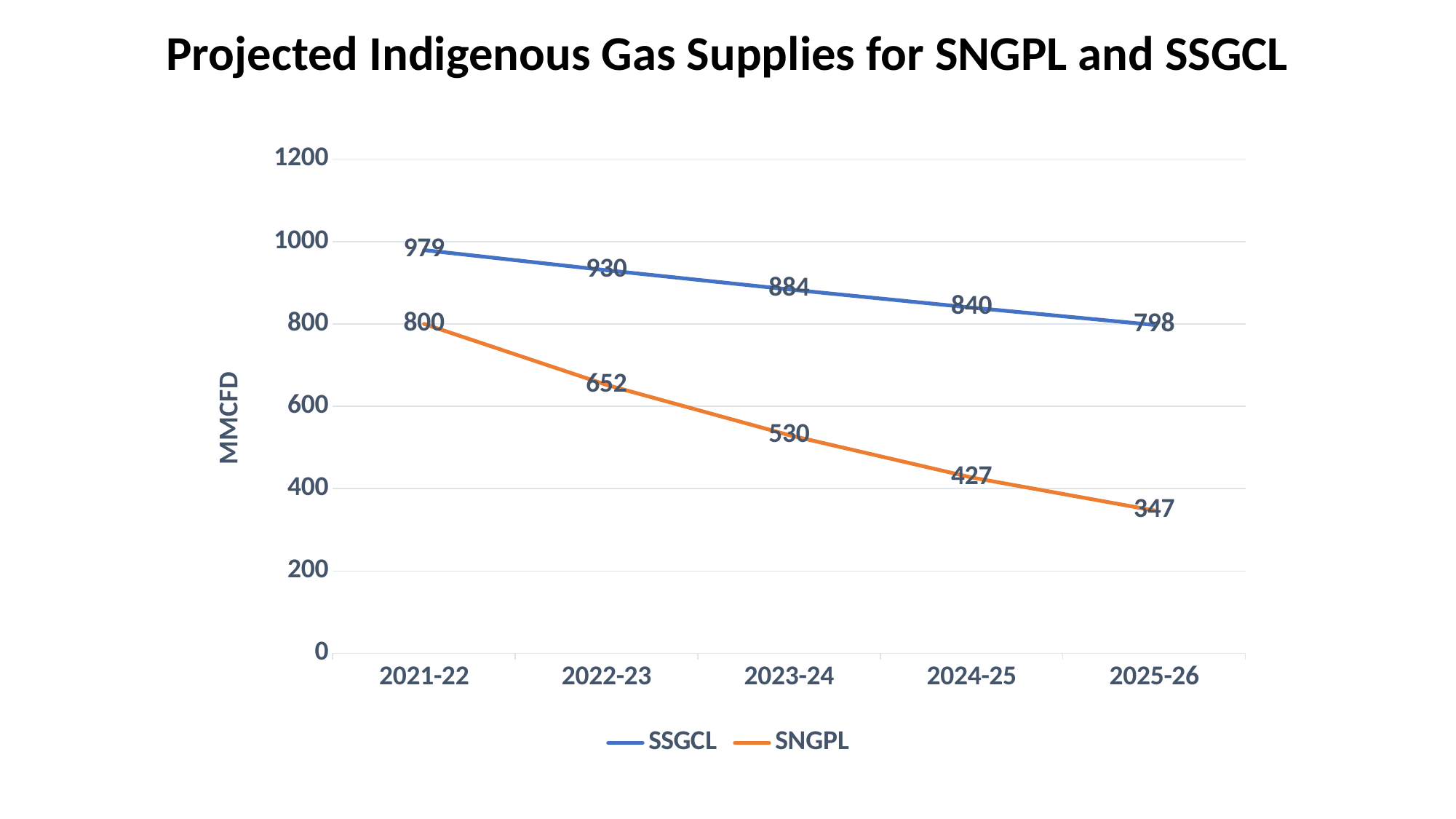
What is the projected SNGPL gas supply for 2025-26? 347 Which is larger in 2022-23, the SSGCL supply or the SNGPL supply? SSGCL In which year is the SSGCL supply highest? 2021-22 What kind of chart is shown on the slide? Line chart What is the difference between the SSGCL and SNGPL supplies in 2024-25? 413 Do the SSGCL values rise or fall from 2021-22 to 2025-26? Fall How many series does the legend list? 2 What is the projected SNGPL gas supply for 2021-22? 800 How many years are shown on the x axis? 5 By how much does the SNGPL supply fall from 2021-22 to 2025-26? 453 In which year is the SNGPL supply lowest? 2025-26 What is the projected SSGCL gas supply for 2023-24? 884